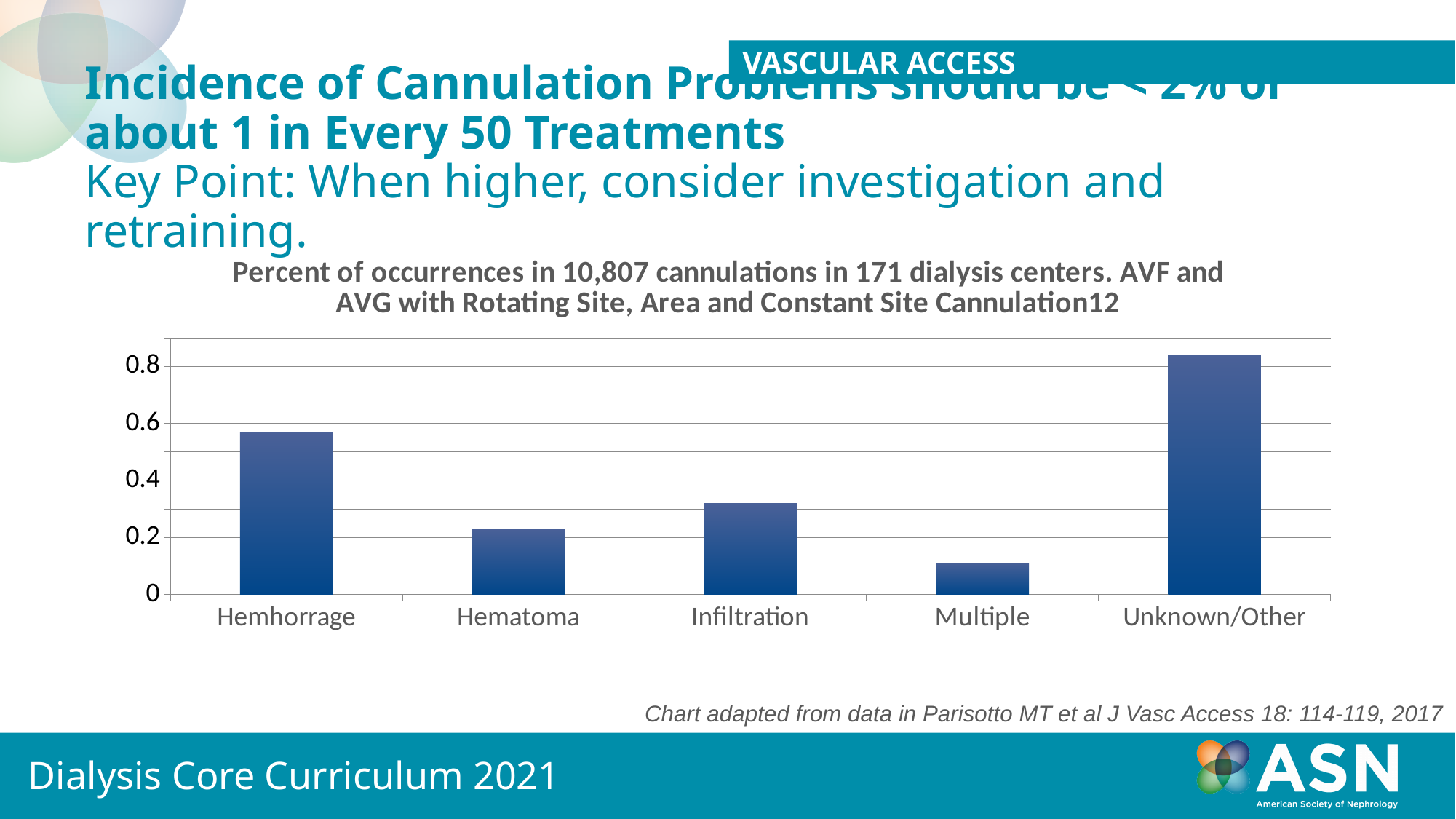
Is the value for Infiltration greater or less than 0.4? less How many categories are plotted on the x axis of the chart? 5 Which is larger, the value for Hemhorrage or the value for Infiltration? Hemhorrage Is the value for Hemhorrage greater or less than 0.6? less What is the highest tick value shown on the y axis of the chart? 0.8 Which category has the highest bar in the chart? Unknown/Other Is the value for Hematoma greater or less than 0.2? greater What kind of chart is shown on the slide? bar chart Which is larger, the value for Hematoma or the value for Infiltration? Infiltration Which category has the lowest bar in the chart? Multiple